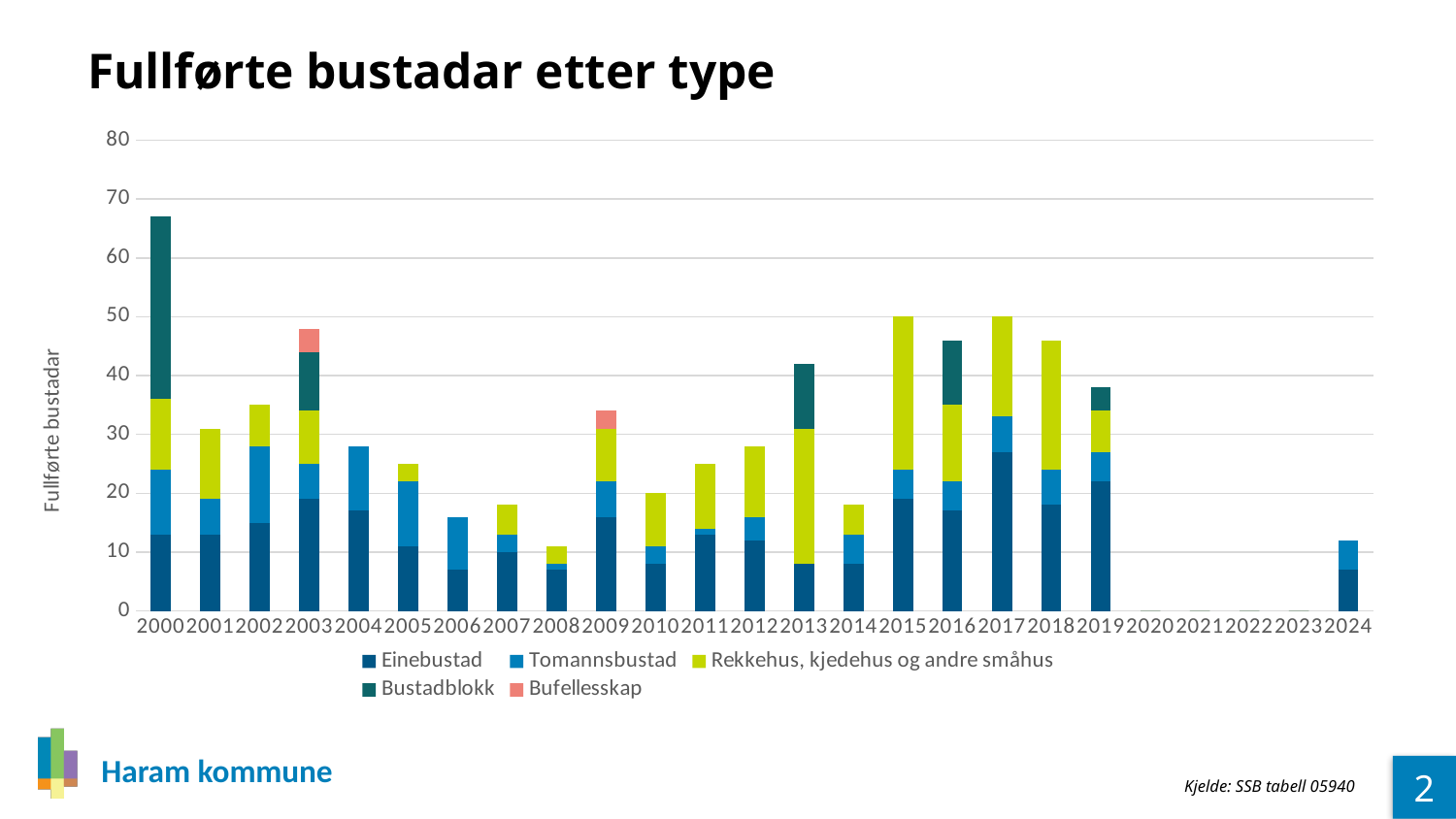
How many years are shown on the x axis? 25 How many series does the legend list? 5 Which year has the tallest stacked bar? 2000 Is the total for 2006 greater or less than 20? less What kind of chart is shown on the slide? Stacked bar chart Is the total for 2019 greater or less than 40? less Is the total for 2000 greater or less than 60? greater Which year has the larger total, 2013 or 2014? 2013 What is the title of the chart? Fullførte bustadar etter type Which series is shown in the salmon/pink colour in the legend? Bufellesskap Which year has the larger total, 2015 or 2019? 2015